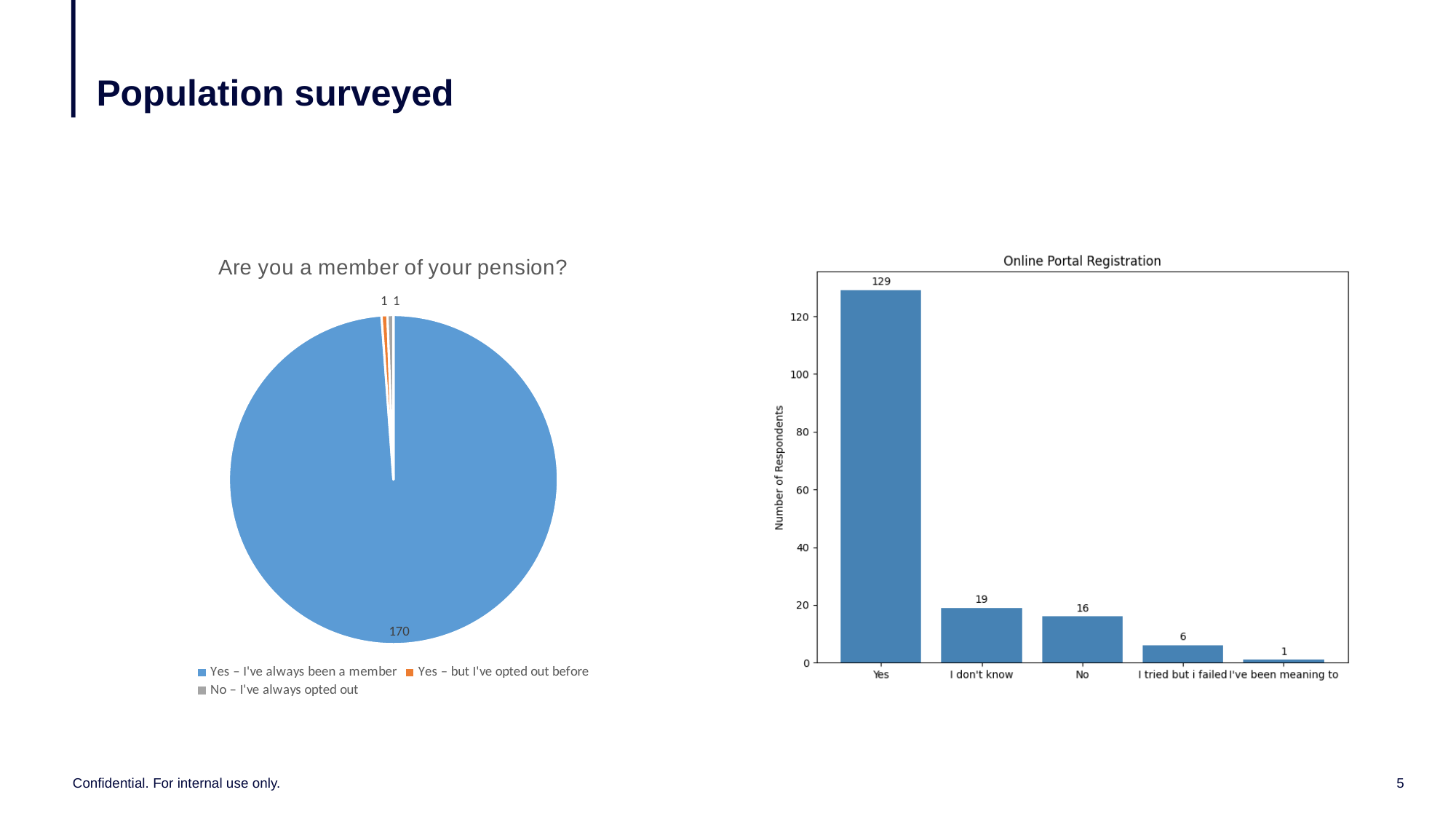
What kind of chart is the 'Online Portal Registration' chart? bar chart In the 'Online Portal Registration' chart, what is the difference between the values for 'Yes' and 'No'? 113 In the 'Online Portal Registration' chart, what is the value for 'Yes'? 129 In the 'Online Portal Registration' chart, how many categories are shown on the x axis? 5 In the 'Online Portal Registration' chart, what is the value for 'I tried but i failed'? 6 In the 'Are you a member of your pension?' pie chart, which category has the largest slice? Yes – I've always been a member In the 'Online Portal Registration' chart, which is larger: 'I don't know' or 'No'? I don't know In the 'Online Portal Registration' chart, what is the value for 'I don't know'? 19 What kind of chart is the 'Are you a member of your pension?' chart? pie chart In the 'Are you a member of your pension?' pie chart, what is the value for 'Yes – I've always been a member'? 170 In the 'Online Portal Registration' chart, which category has the lowest value? I've been meaning to In the 'Are you a member of your pension?' pie chart, how many slices are there? 3